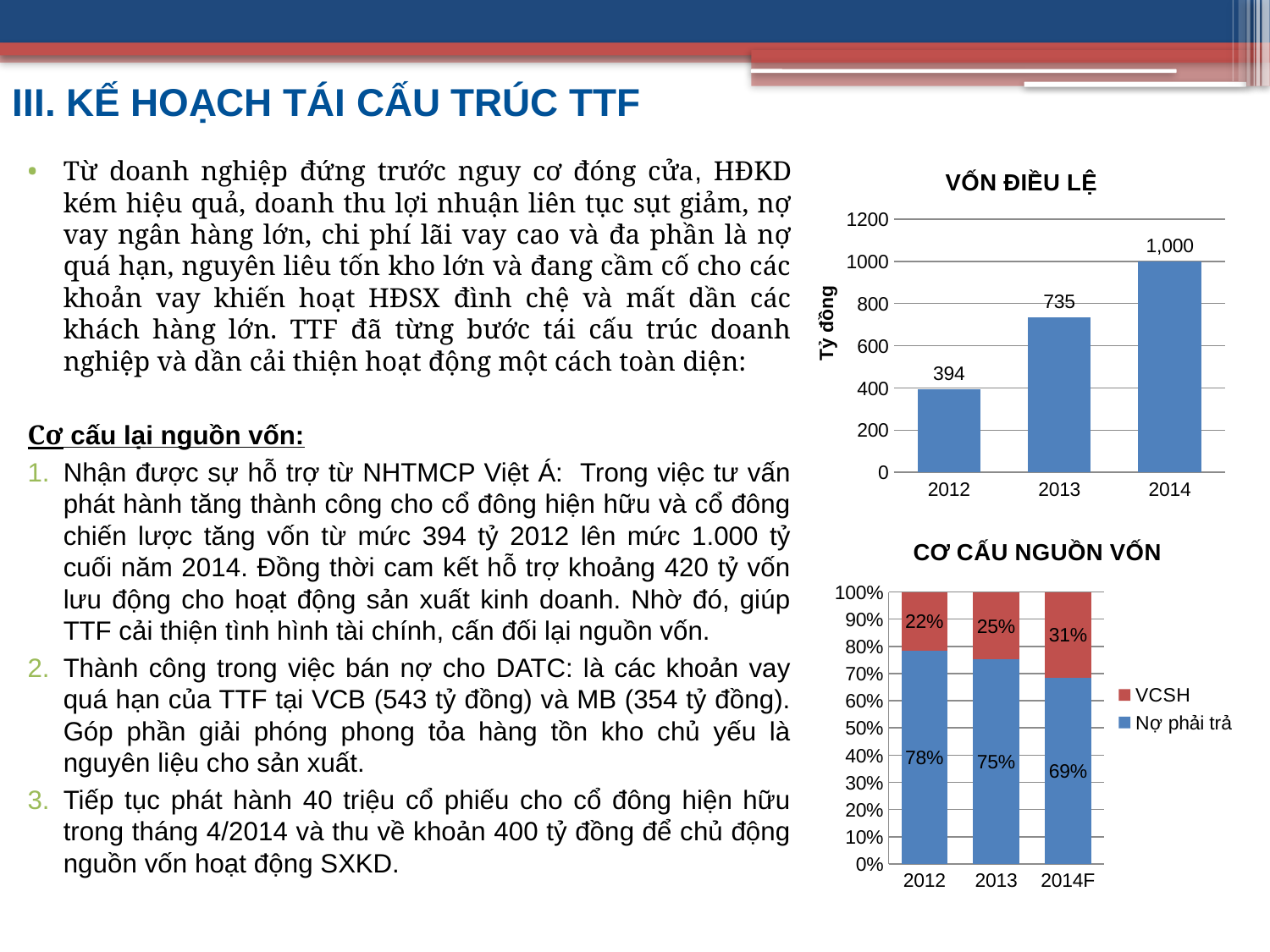
In the 'VỐN ĐIỀU LỆ' chart, what is the y-axis label? Tỷ đồng In the 'CƠ CẤU NGUỒN VỐN' chart, how many series does the legend list? 2 In the 'VỐN ĐIỀU LỆ' chart, what is the value for 2014? 1,000 In the 'VỐN ĐIỀU LỆ' chart, what is the difference between the 2013 and 2012 values? 341 In the 'VỐN ĐIỀU LỆ' chart, which year has the lowest value? 2012 In the 'VỐN ĐIỀU LỆ' chart, do the values rise or fall from 2012 to 2014? rise In the 'CƠ CẤU NGUỒN VỐN' chart, what is the VCSH share for 2014F? 31% In the 'VỐN ĐIỀU LỆ' chart, what is the value for 2012? 394 In the 'CƠ CẤU NGUỒN VỐN' chart, what is the 'Nợ phải trả' share for 2012? 78% In the 'CƠ CẤU NGUỒN VỐN' chart, which year has the highest VCSH share? 2014F What kind of chart is the 'CƠ CẤU NGUỒN VỐN' chart? stacked bar chart In the 'CƠ CẤU NGUỒN VỐN' chart, is the 'Nợ phải trả' share larger in 2013 or in 2014F? 2013